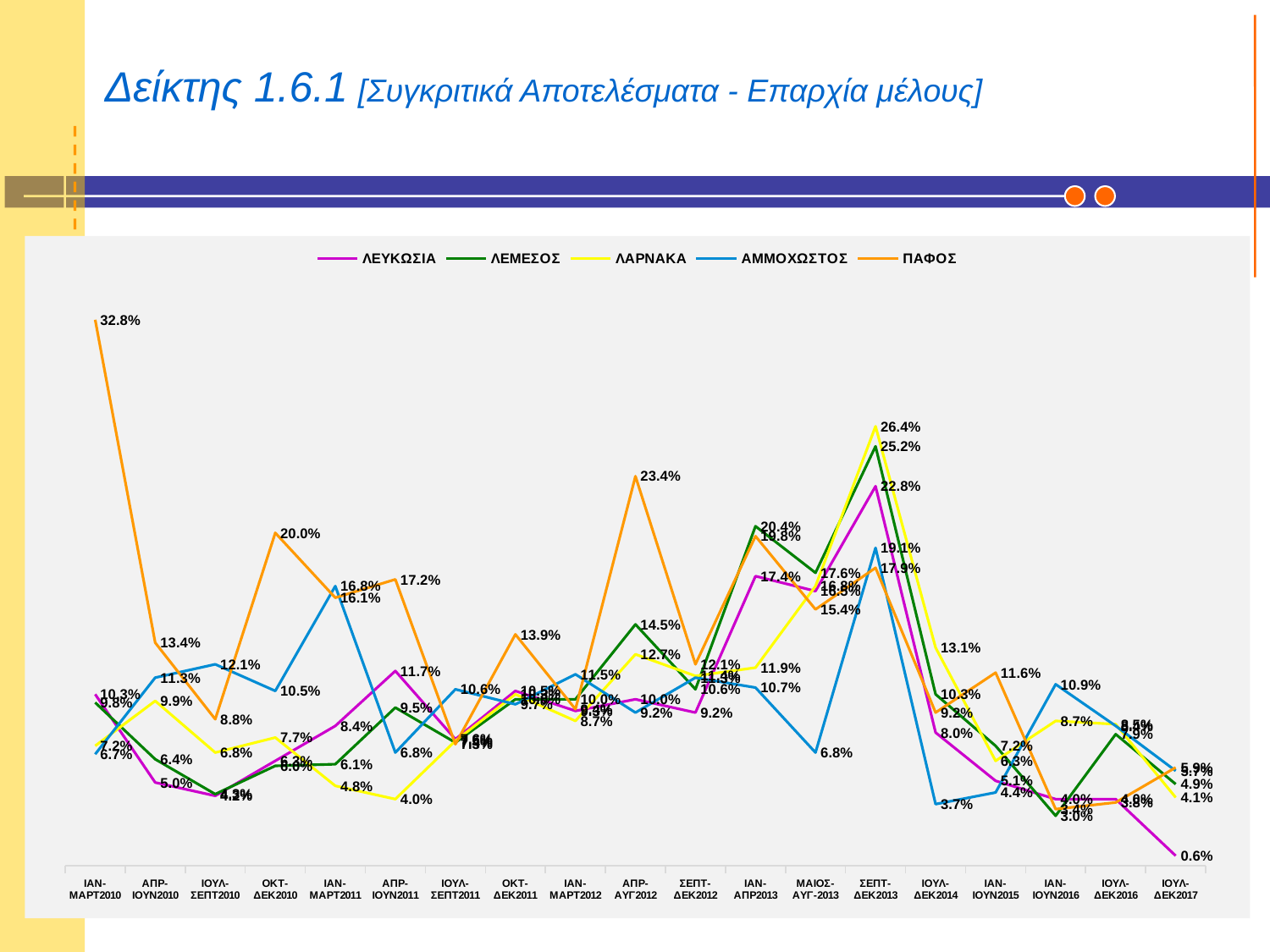
Which series is drawn in orange in the legend? ΠΑΦΟΣ Which series has the highest value in ΣΕΠΤ-ΔΕΚ2013? ΛΑΡΝΑΚΑ In which period does ΠΑΦΟΣ reach its highest value? ΙΑΝ-ΜΑΡΤ2010 What is the value for ΠΑΦΟΣ in ΙΑΝ-ΜΑΡΤ2010? 32.8% What is the value for ΛΑΡΝΑΚΑ in ΣΕΠΤ-ΔΕΚ2013? 26.4% What is the value for ΠΑΦΟΣ in ΑΠΡ-ΑΥΓ2012? 23.4% How many periods are shown along the x axis? 19 What is the difference between ΛΑΡΝΑΚΑ (26.4%) and ΛΕΜΕΣΟΣ (25.2%) in ΣΕΠΤ-ΔΕΚ2013? 1.2 percentage points How many series does the legend list? 5 In ΣΕΠΤ-ΔΕΚ2013, which is larger: the value for ΑΜΜΟΧΩΣΤΟΣ or the value for ΠΑΦΟΣ? ΑΜΜΟΧΩΣΤΟΣ What is the value for ΛΕΥΚΩΣΙΑ in ΙΟΥΛ-ΔΕΚ2017? 0.6% What type of chart is shown on the slide? Line chart